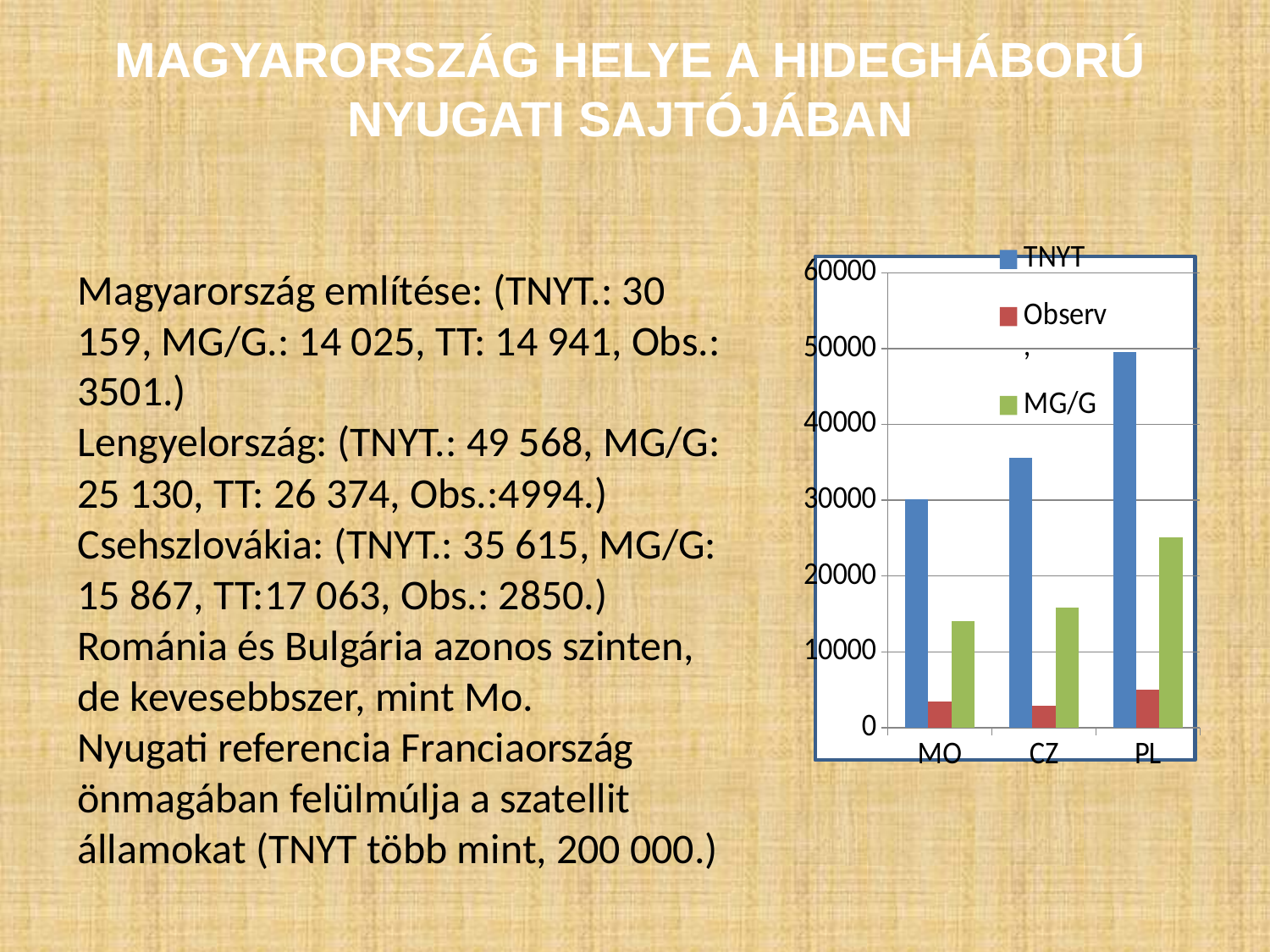
Is the TNYT value for MO greater or less than 40000? less Which category has the highest Observ value? PL Which category has the highest TNYT value? PL Which category has the lowest TNYT value? MO How many series does the chart's legend list? 3 What colour are the TNYT bars in the chart? blue Is the MG/G value for PL greater or less than 20000? greater Which is larger, the MG/G value for CZ or the MG/G value for MO? CZ Is the TNYT value for PL greater or less than 40000? greater What kind of chart is shown on the slide? bar chart Do the TNYT values rise or fall going from MO to CZ to PL? rise How many categories are shown on the x axis of the chart? 3